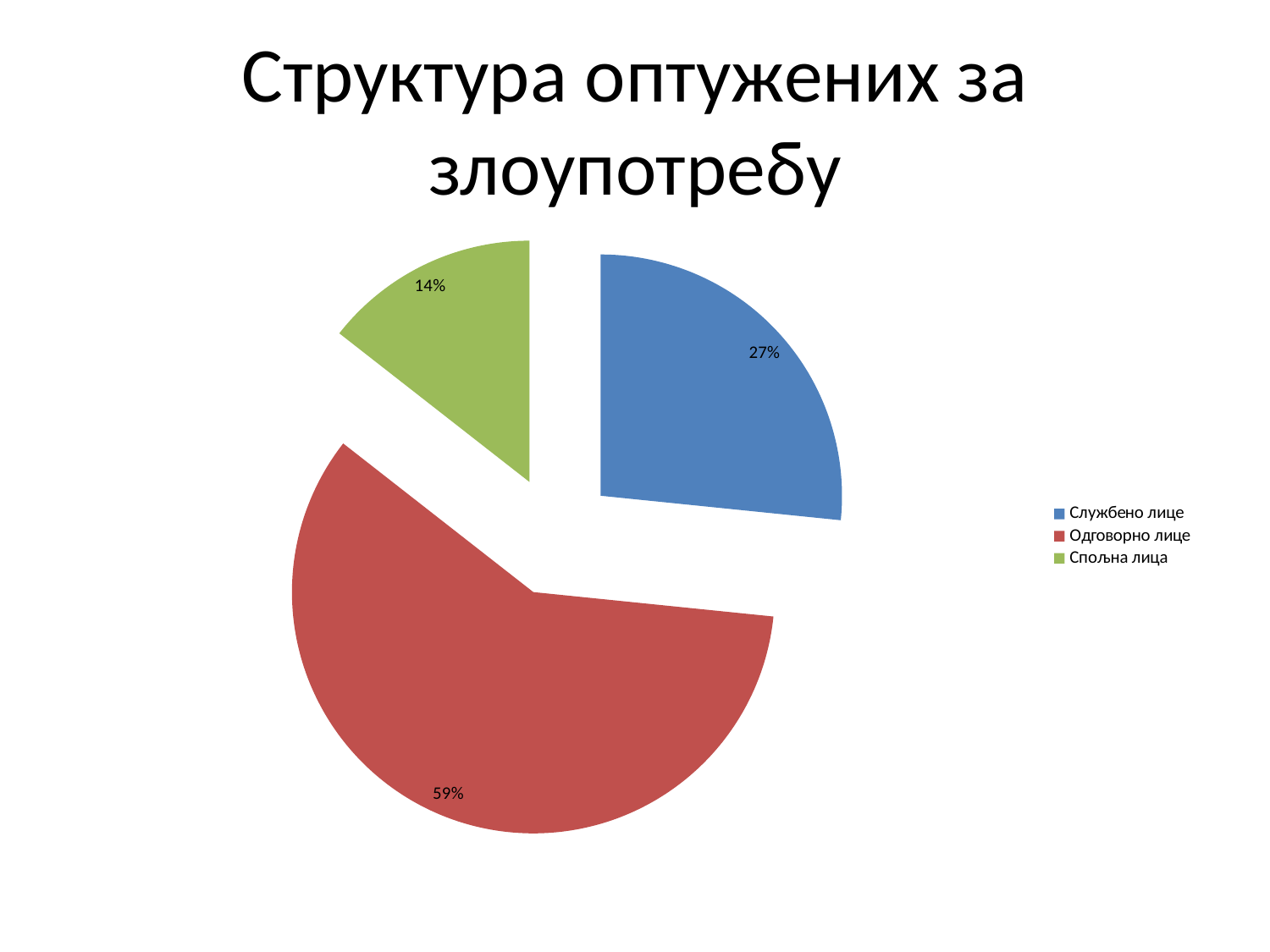
What share of the pie does Службено лице represent? 27% How many slices does the pie chart have? 3 What colour is the slice for Одговорно лице? Red Which is larger, the share for Службено лице or the share for Спољна лица? Службено лице What is the difference in percentage points between Службено лице and Спољна лица? 13 What is the title of the chart on the slide? Структура оптужених за злоупотребу What is the difference in percentage points between Одговорно лице and Службено лице? 32 What share of the pie does Одговорно лице represent? 59% Which category has the largest share of the pie? Одговорно лице What share of the pie does Спољна лица represent? 14% Which category has the smallest share of the pie? Спољна лица What kind of chart is shown on the slide? Pie chart